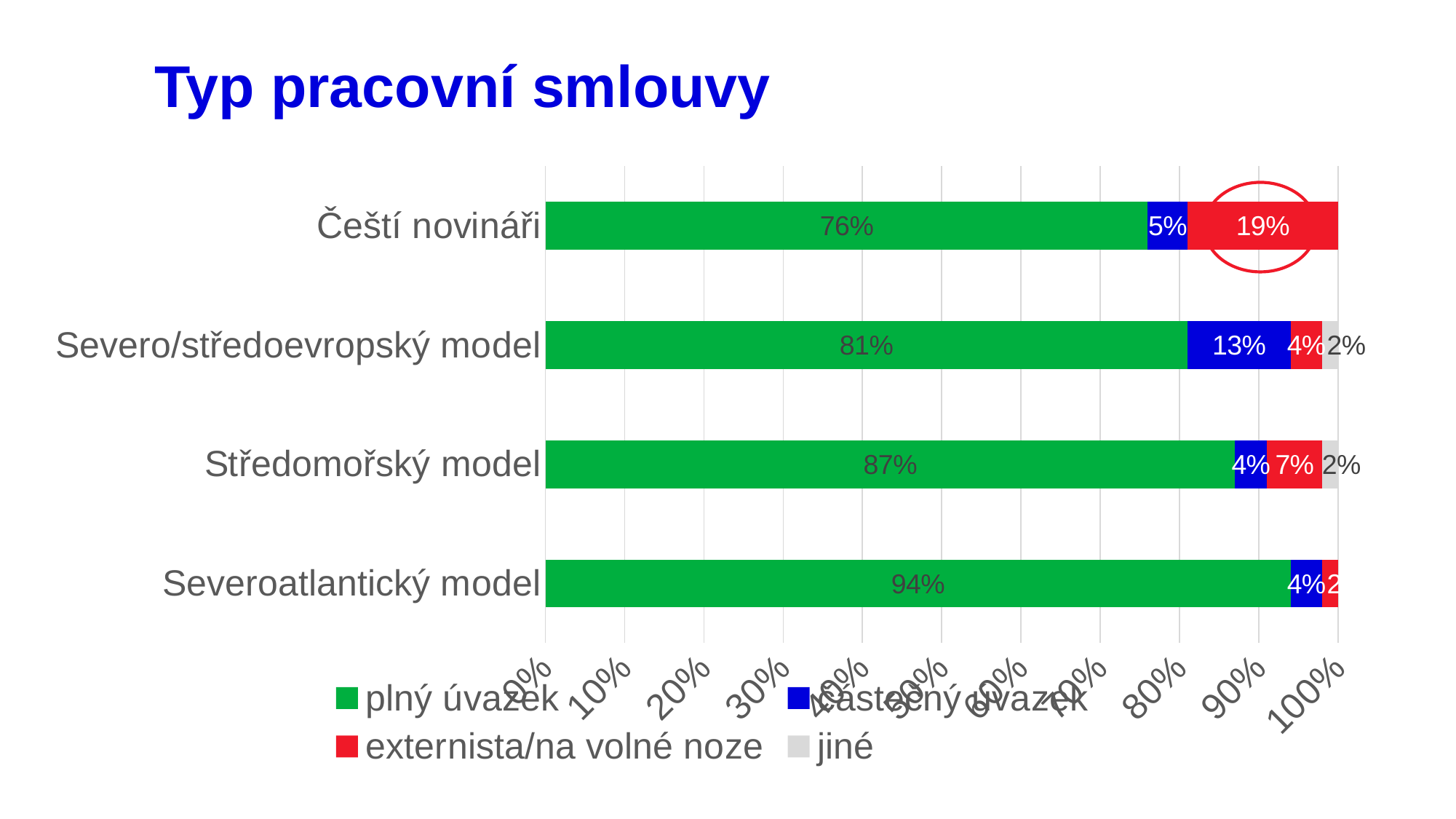
How many series does the legend list? 4 Which category has the highest value for plný úvazek? Severoatlantický model What is the value for částečný úvazek for Severo/středoevropský model? 13% What is the difference between the plný úvazek values for Severoatlantický model and Čeští novináři? 18 percentage points How many categories are shown on the chart? 4 Which has a larger externista/na volné noze value, Čeští novináři or Středomořský model? Čeští novináři What is the value for plný úvazek for Čeští novináři? 76% What is the title of the slide? Typ pracovní smlouvy What is the value for externista/na volné noze for Čeští novináři? 19% What kind of chart is shown on the slide? Stacked bar chart What is the value for jiné for Středomořský model? 2% Which category has the lowest value for plný úvazek? Čeští novináři